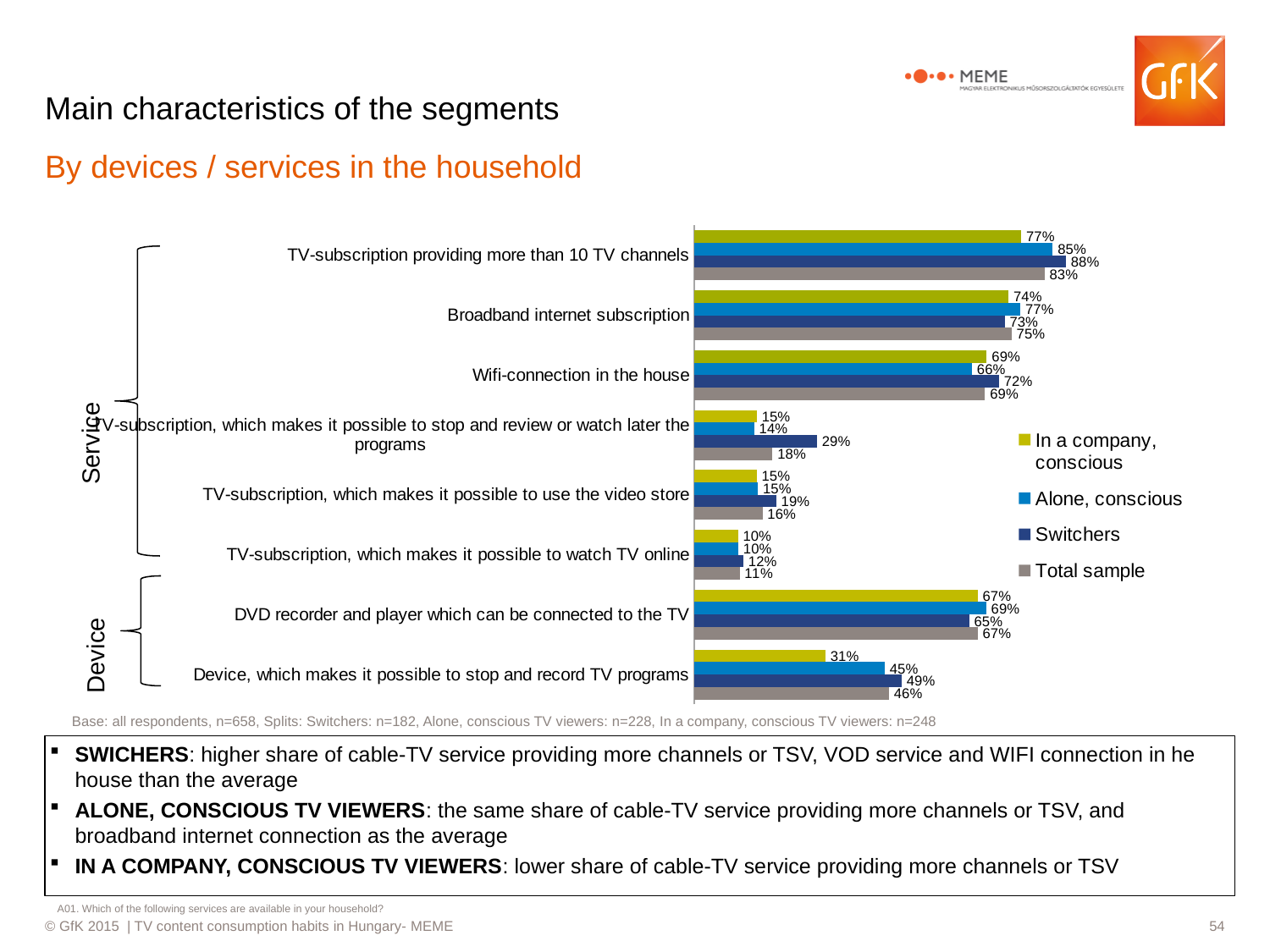
What kind of chart is shown on the slide? Bar chart For "DVD recorder and player which can be connected to the TV", which is larger: the value for "Alone, conscious" or for Switchers? Alone, conscious What is the value for "Alone, conscious" for "Wifi-connection in the house"? 66% What is the value for Switchers for "TV-subscription providing more than 10 TV channels"? 88% Which series has the highest value for "TV-subscription, which makes it possible to stop and review or watch later the programs"? Switchers What is the value for "In a company, conscious" for "Device, which makes it possible to stop and record TV programs"? 31% What is the Total sample value for "Broadband internet subscription"? 75% Which category has the lowest Total sample value? TV-subscription, which makes it possible to watch TV online How many series does the legend list? 4 How many categories are shown on the chart? 8 Which two groups are the categories divided into on the left side of the chart? Service and Device What is the difference between the Switchers value and the Total sample value for "TV-subscription, which makes it possible to stop and review or watch later the programs"? 11%